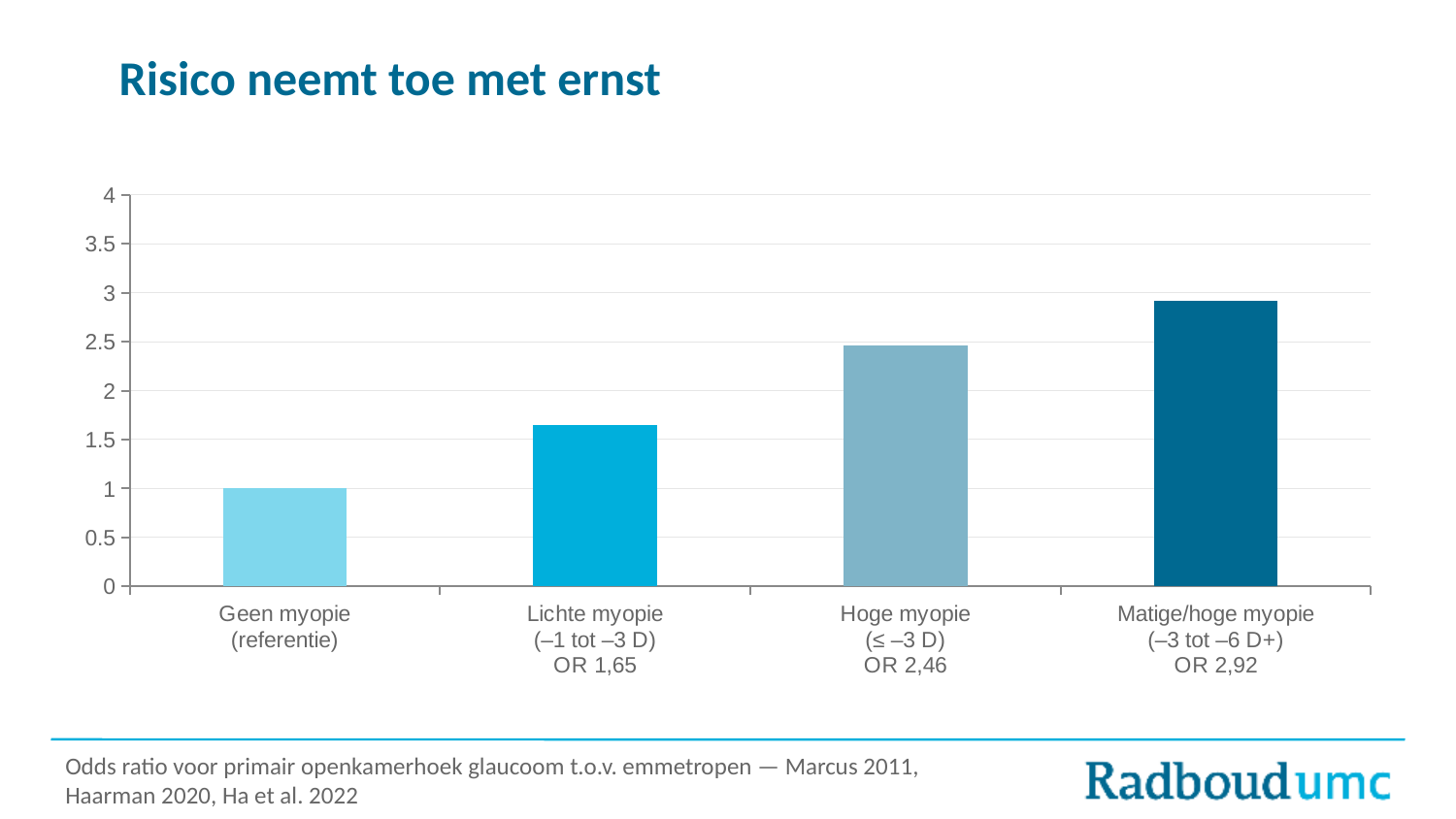
Which is larger, the bar for Hoge myopie or the bar for Lichte myopie? Hoge myopie How many categories are shown on the x axis of the chart? 4 What is the odds ratio shown for Matige/hoge myopie (–3 tot –6 D+)? OR 2,92 Is the value for Hoge myopie greater or less than 2? greater What is the difference between the odds ratio for Matige/hoge myopie and the odds ratio for Lichte myopie? 1,27 What value does the bar for Geen myopie (referentie) reach on the y axis? 1 What kind of chart is shown on the slide? bar chart Do the bar values rise or fall from left to right along the x axis? rise What is the odds ratio shown for Hoge myopie (≤ –3 D)? OR 2,46 What is the odds ratio shown for Lichte myopie (–1 tot –3 D)? OR 1,65 Which category has the highest bar? Matige/hoge myopie (–3 tot –6 D+) Which category has the lowest bar? Geen myopie (referentie)